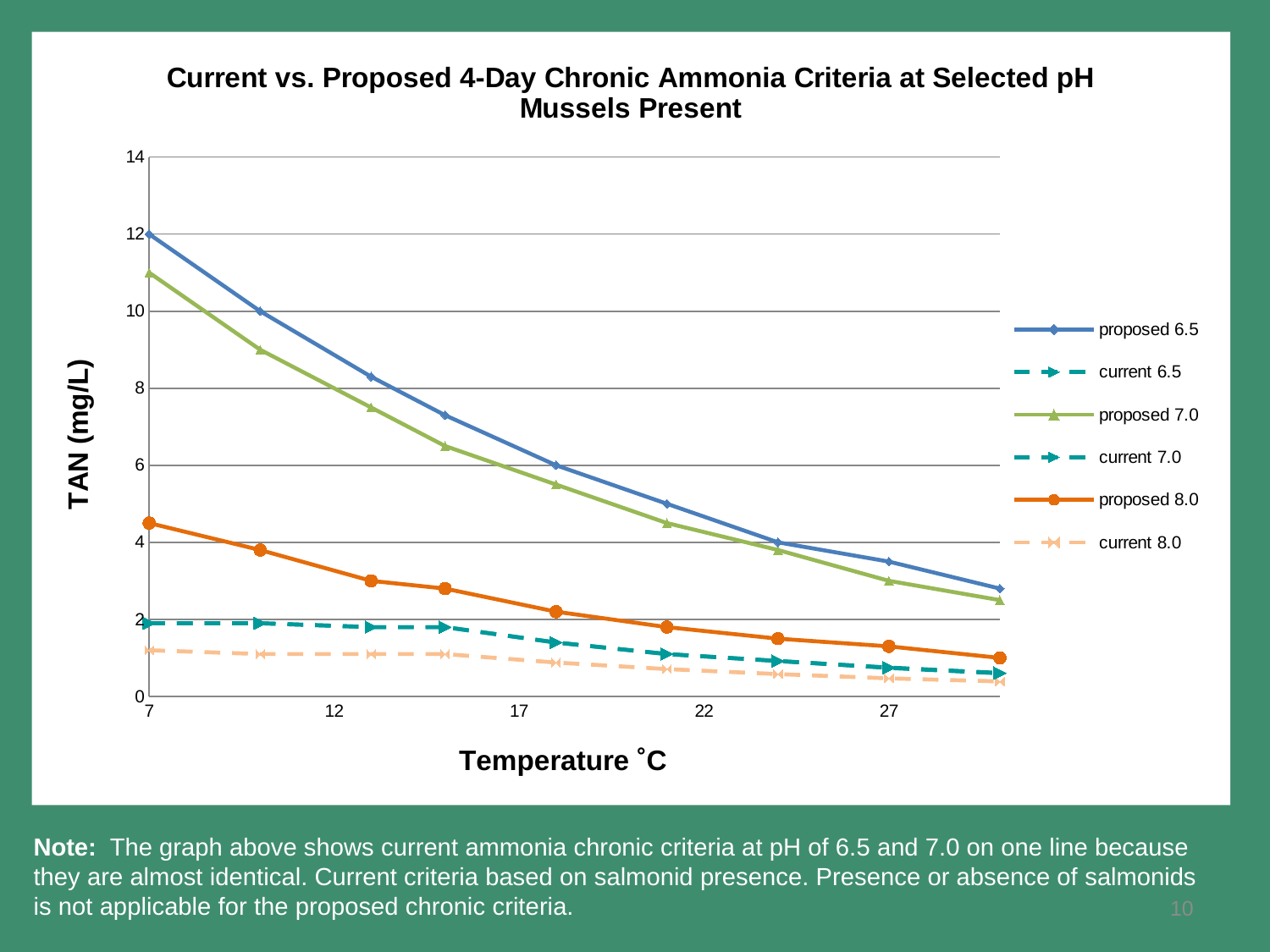
What is the value of the proposed 6.5 series at 7 °C? 12 Which series has the lowest value at 7 °C? current 8.0 Is the value for current 8.0 at 7 °C greater or less than 2? less Is the value for proposed 8.0 at 7 °C greater or less than 4? greater Is the value for proposed 6.5 at 27 °C greater or less than 4? less What is the label of the y axis? TAN (mg/L) At 7 °C, which is larger: proposed 6.5 or proposed 7.0? proposed 6.5 What kind of chart is shown on the slide? line chart How many series does the legend list? 6 Do the values of the proposed 6.5 series rise or fall as temperature increases? fall Which series has the highest value at 7 °C? proposed 6.5